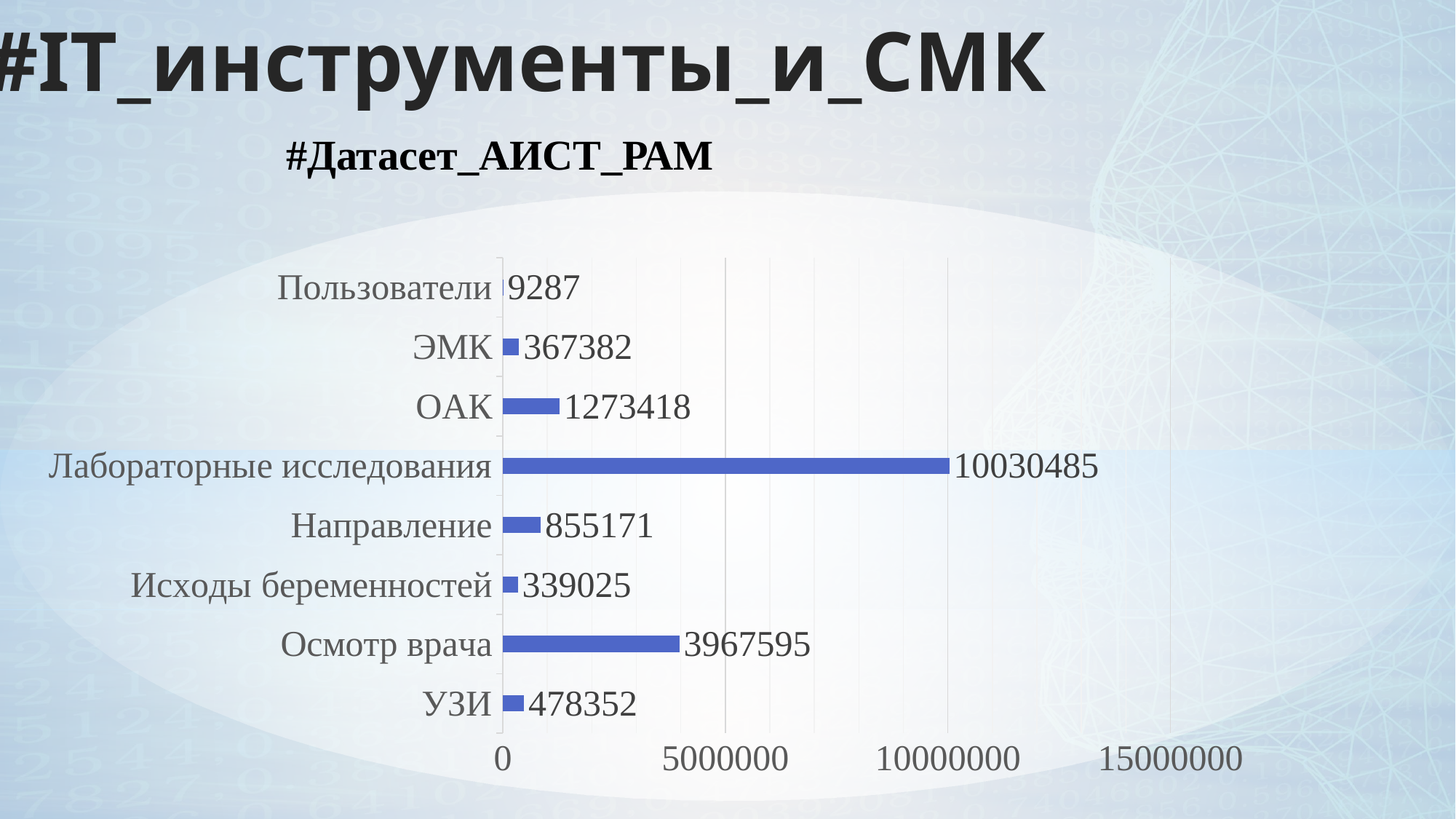
Which is larger, the value for Направление or the value for Исходы беременностей? Направление Which category has the highest value? Лабораторные исследования What is the difference between the values for Осмотр врача and ОАК? 2694177 How many categories are shown in the chart? 8 Which category has the lowest value? Пользователи What is the difference between the values for УЗИ and ЭМК? 110970 Is the value for Лабораторные исследования greater or less than 5000000? greater What is the value for Пользователи? 9287 What is the value for Осмотр врача? 3967595 What kind of chart is shown on the slide? bar chart What is the value for Лабораторные исследования? 10030485 What is the value for УЗИ? 478352